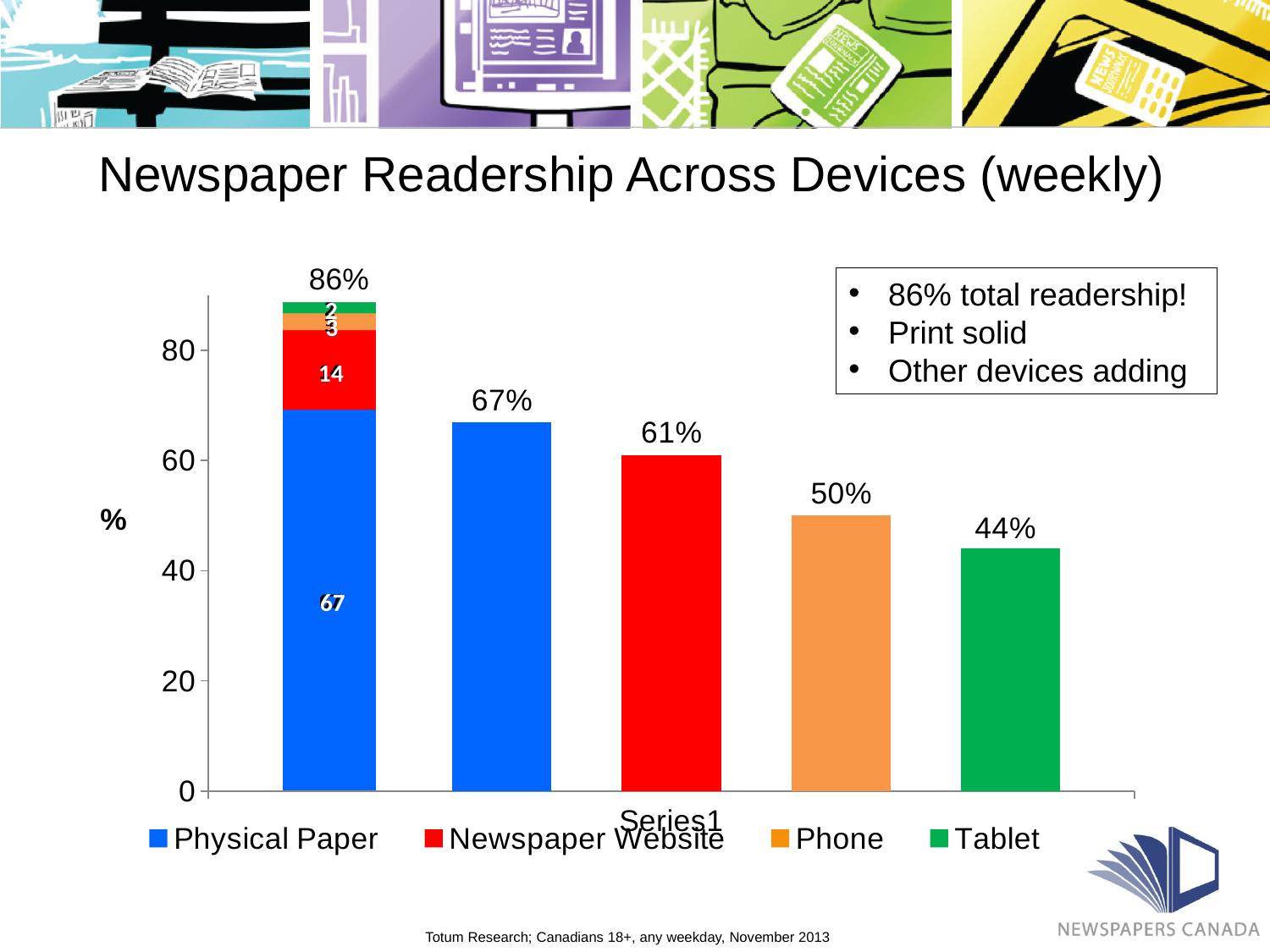
How many series does the legend list? 4 What is the weekly readership value shown for Phone? 50% What kind of chart is shown on the slide? Bar chart Which is larger, the Phone value or the Newspaper Website value? Newspaper Website What value is labelled on the Newspaper Website (red) segment of the stacked bar? 14 What is the difference between the Physical Paper value and the Tablet value? 23 percentage points What is the weekly readership value shown for Physical Paper? 67% Which device has the highest individual readership bar? Physical Paper What is the total readership shown on top of the stacked bar? 86% Which device has the lowest individual readership bar? Tablet What is the weekly readership value shown for Tablet? 44% What is the weekly readership value shown for Newspaper Website? 61%